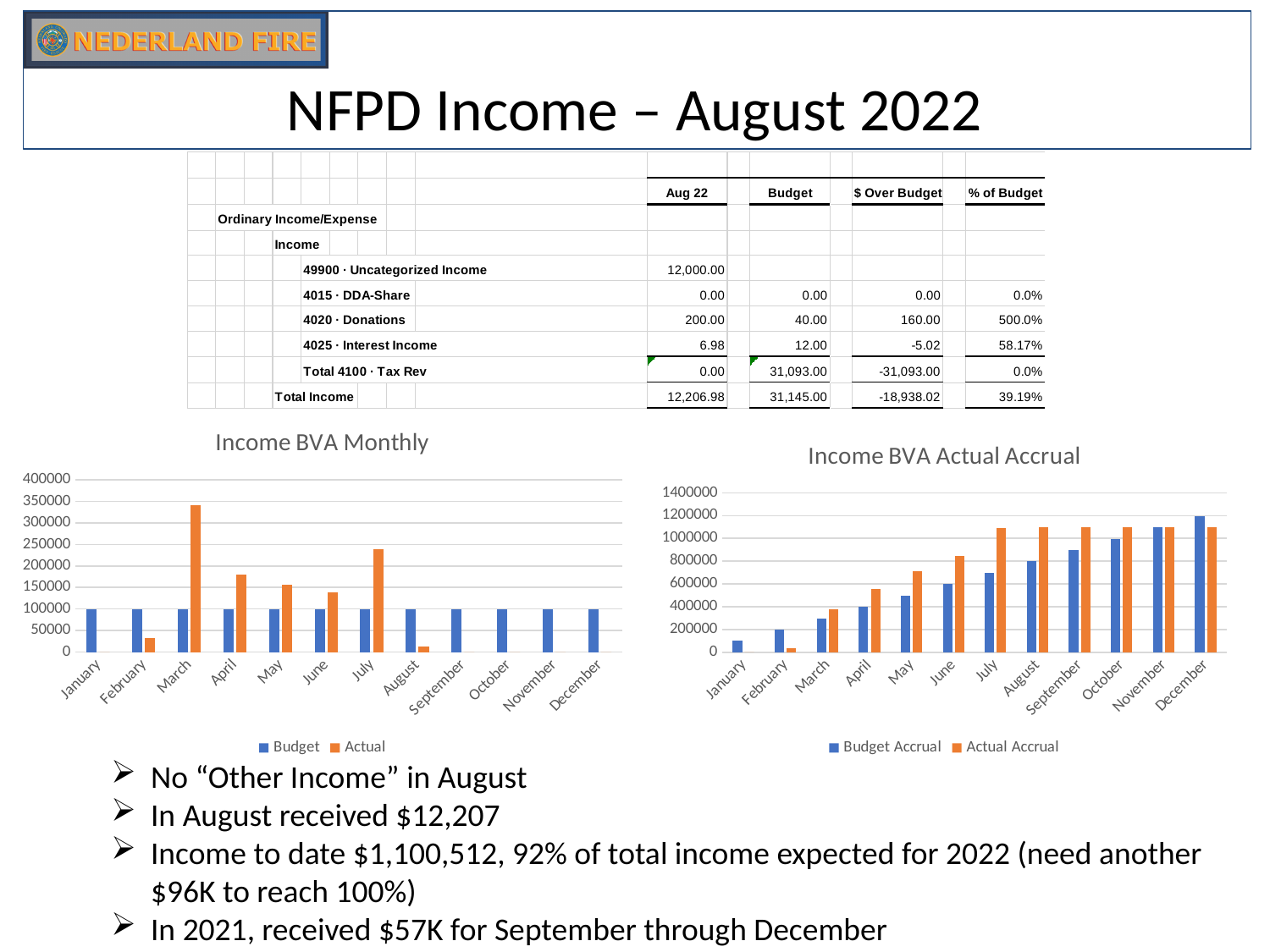
What are the legend entries of the Income BVA Actual Accrual chart? Budget Accrual, Actual Accrual In the Income BVA Actual Accrual chart, is the Budget Accrual value for December greater or less than 1000000? greater In the Income BVA Actual Accrual chart, which is larger for January, Budget Accrual or Actual Accrual? Budget Accrual How many series does the legend of the Income BVA Monthly chart list? 2 In the Income BVA Monthly chart, is the Actual value for August greater or less than 50000? less In the Income BVA Actual Accrual chart, do the Budget Accrual values rise or fall from January to December? rise In the Income BVA Monthly chart, which is larger, the Actual value for July or the Actual value for April? July How many months are shown on the x axis of the Income BVA Monthly chart? 12 In the Income BVA Monthly chart, which month has the highest Actual value? March In the Income BVA Actual Accrual chart, is the Actual Accrual value for February greater or less than 200000? less What kind of chart is the Income BVA Monthly chart? bar chart